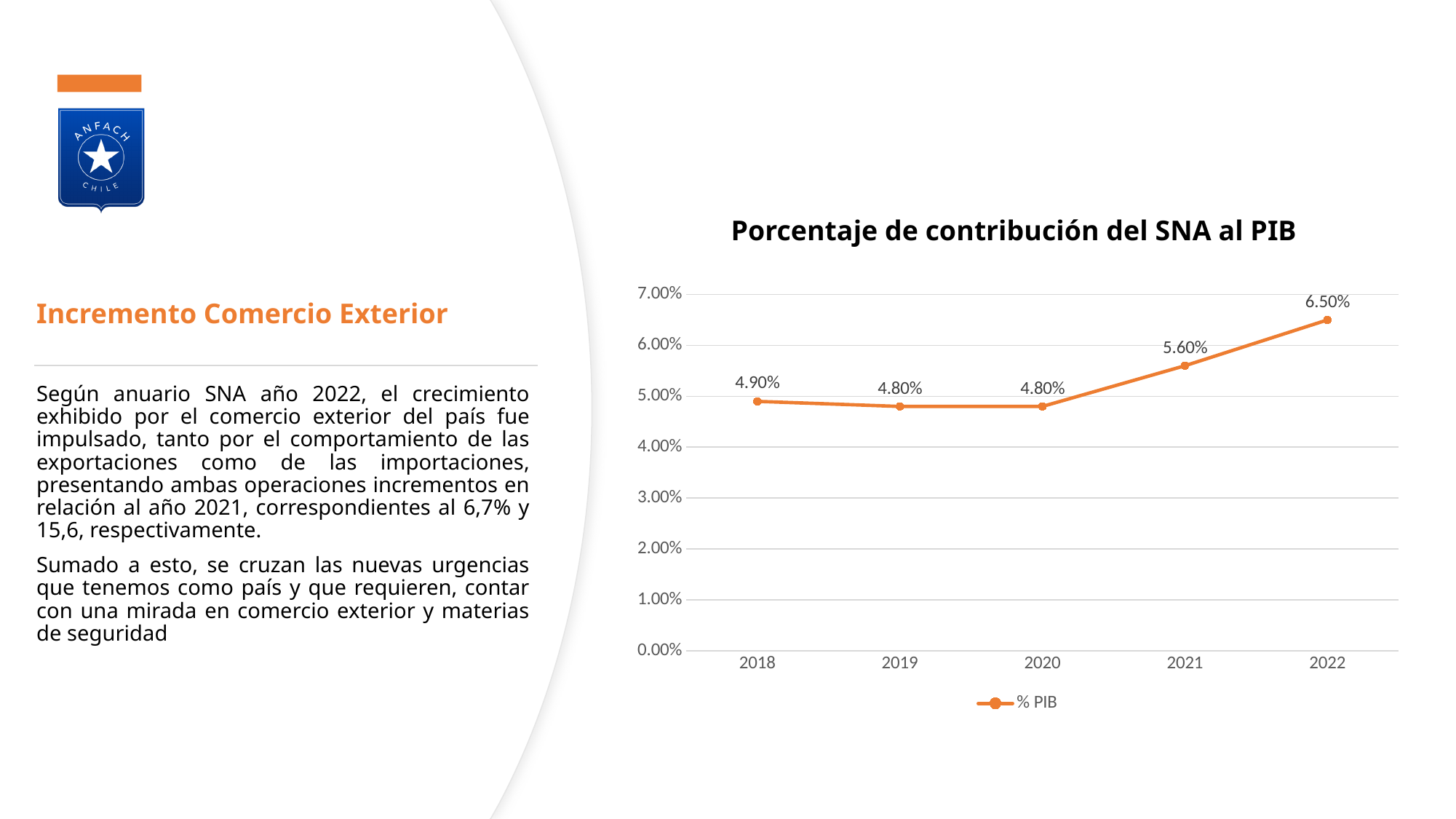
What is the value for 2021? 5.60% What is the value for 2018? 4.90% What kind of chart is shown? line chart What is the difference between the values for 2018 and 2019? 0.10% What is the difference between the values for 2022 and 2021? 0.90% Which is larger, the value for 2021 or the value for 2020? 2021 Which year has the highest value? 2022 Is the value for 2022 greater or less than 6.00%? greater What is the title of the chart? Porcentaje de contribución del SNA al PIB How many series does the legend list? 1 How many years are plotted on the chart? 5 What is the value for 2022? 6.50%